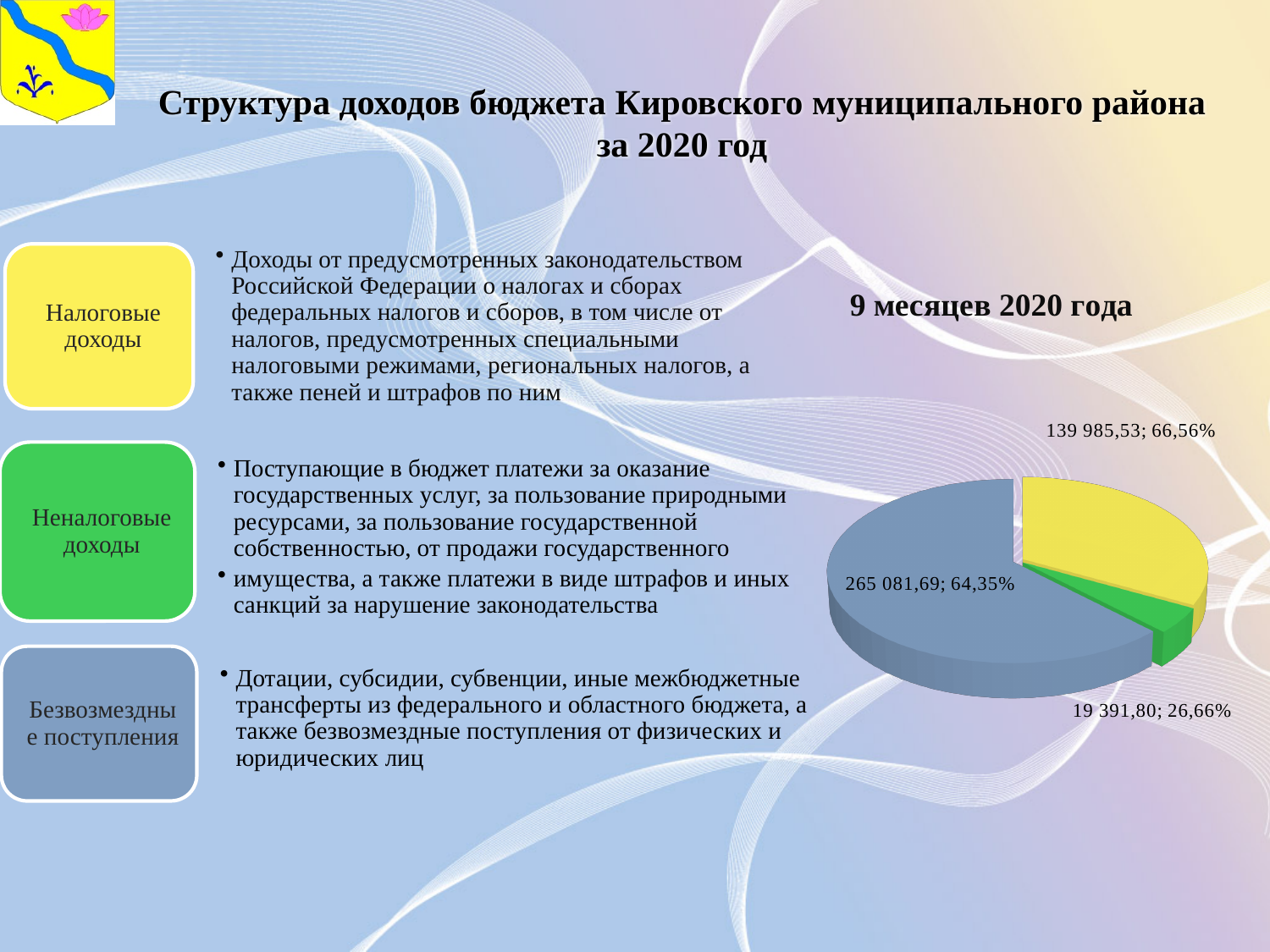
What percentage is printed next to the blue slice of the pie chart? 64,35% What is the title of the pie chart? 9 месяцев 2020 года What value is printed on the blue slice of the pie chart? 265 081,69 Which is larger in the pie chart, the blue slice or the yellow slice? The blue slice What percentage is printed next to the green slice of the pie chart? 26,66% What value is printed on the yellow slice of the pie chart? 139 985,53 What is the difference between the values of the blue slice and the yellow slice in the pie chart? 125 096,16 Which slice of the pie chart has the smallest value? The green slice (19 391,80) How many slices does the pie chart have? 3 Which slice of the pie chart has the largest value? The blue slice (265 081,69) What value is printed on the green slice of the pie chart? 19 391,80 What kind of chart is shown on the slide? Pie chart